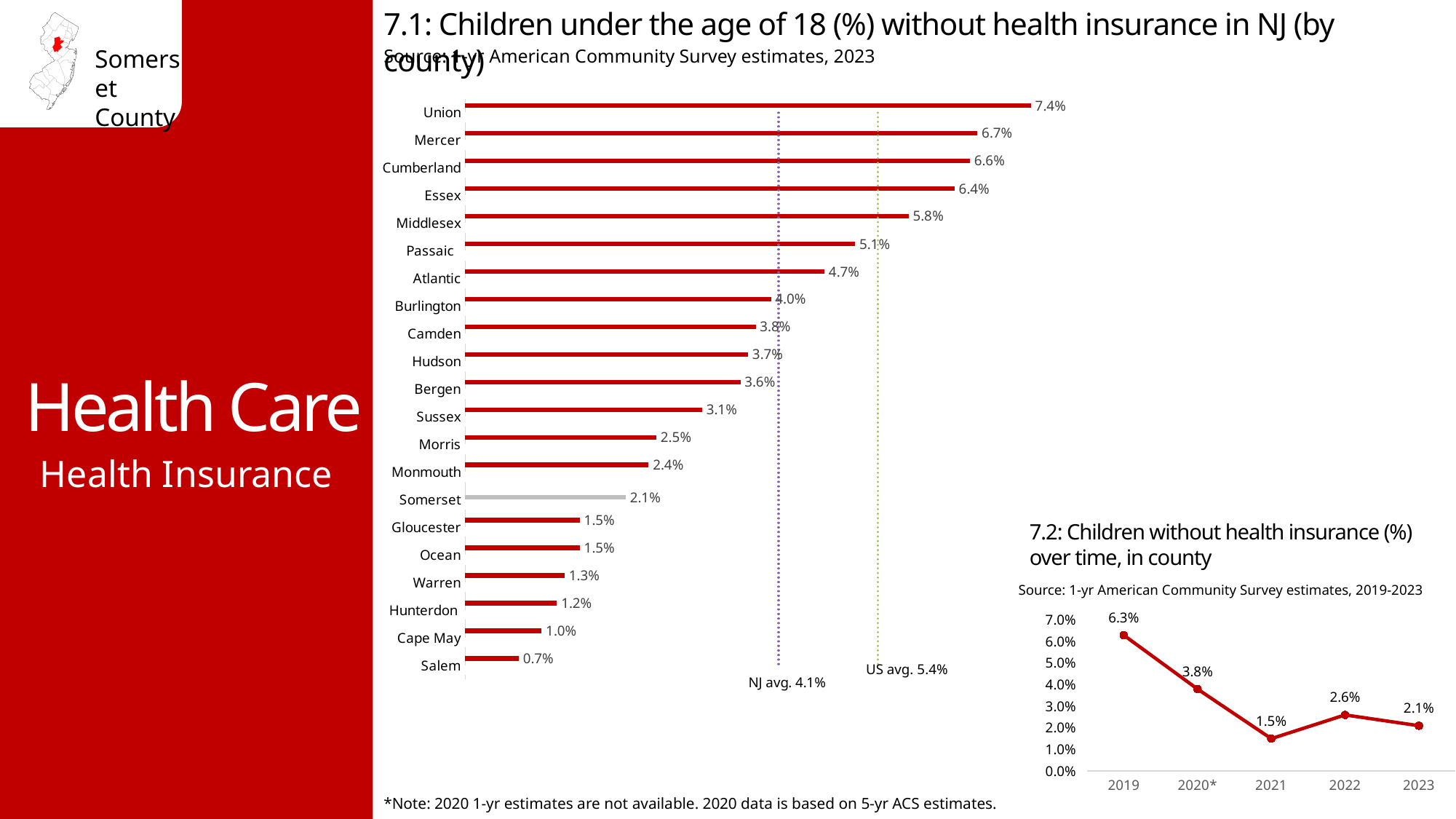
In chart 7.1, which county has the lowest percentage of children without health insurance? Salem In chart 7.1, what is the NJ average shown by the dotted line? 4.1% In chart 7.2, how many data points are plotted? 5 In chart 7.1, how many counties are plotted? 21 In chart 7.1, what is the value for Somerset? 2.1% In chart 7.1, which is larger, the value for Passaic or the value for Atlantic? Passaic In chart 7.2, what is the difference between the values for 2019 and 2023? 4.2% In chart 7.2, which year has the lowest value? 2021 In chart 7.1, which county has the highest percentage of children without health insurance? Union What kind of chart is chart 7.1? Bar chart In chart 7.2, what is the value for 2019? 6.3% In chart 7.1, what is the difference between the values for Union and Mercer? 0.7%